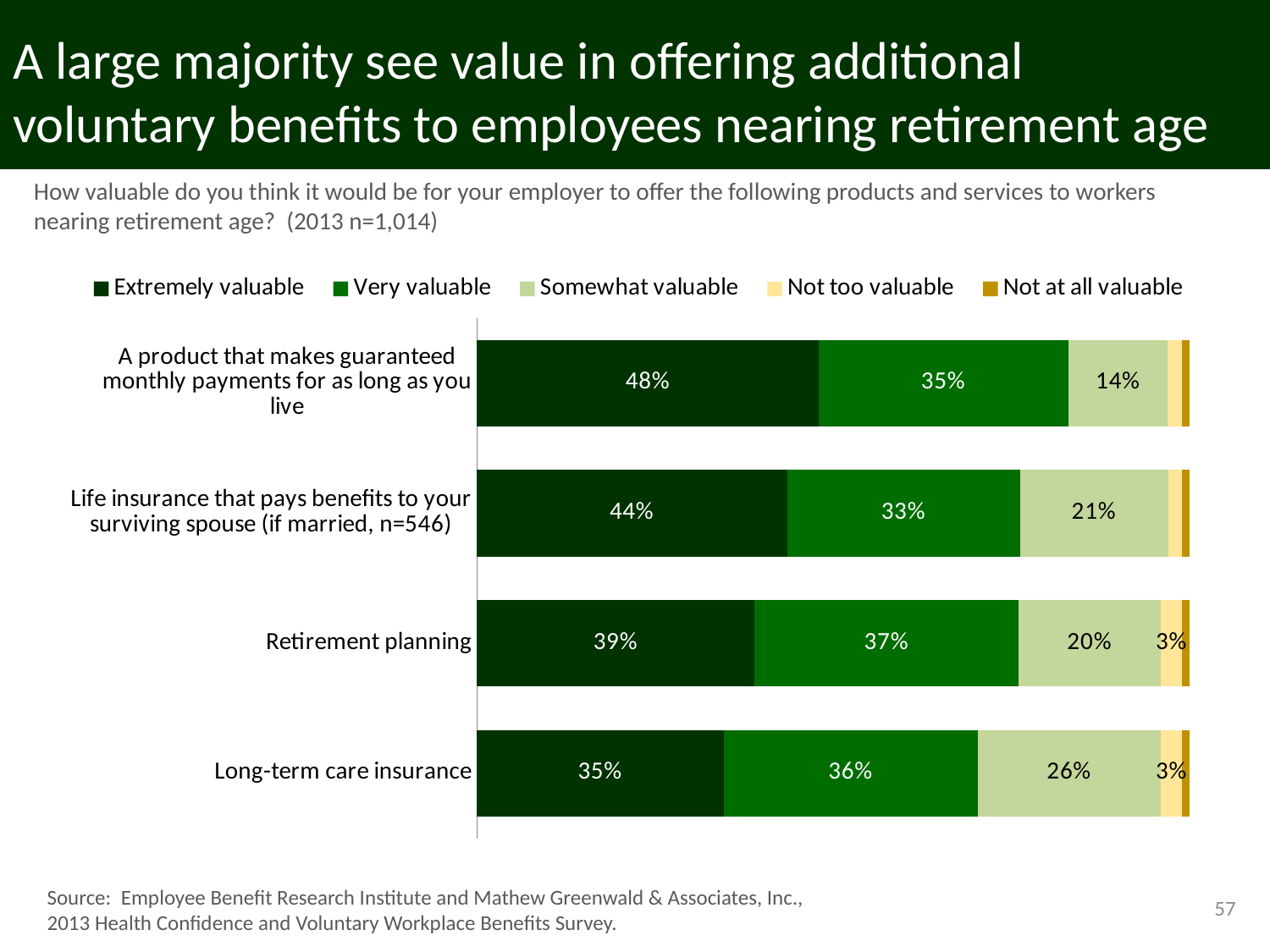
How many series does the legend list? 5 Which legend entry is shown in the lightest green colour? Somewhat valuable Which product or service has the highest share rating it extremely valuable? A product that makes guaranteed monthly payments for as long as you live How many products or services are plotted in the chart? 4 What percentage rated a product that makes guaranteed monthly payments for as long as you live as extremely valuable? 48% What is the difference between the extremely valuable shares for the guaranteed monthly payments product and long-term care insurance? 13% What percentage rated retirement planning as very valuable? 37% Which product or service has the lowest share rating it extremely valuable? Long-term care insurance What kind of chart is shown on the slide? Stacked bar chart Which has a larger somewhat valuable share: retirement planning or long-term care insurance? Long-term care insurance What percentage rated life insurance that pays benefits to your surviving spouse as somewhat valuable? 21% What percentage rated long-term care insurance as not too valuable? 3%